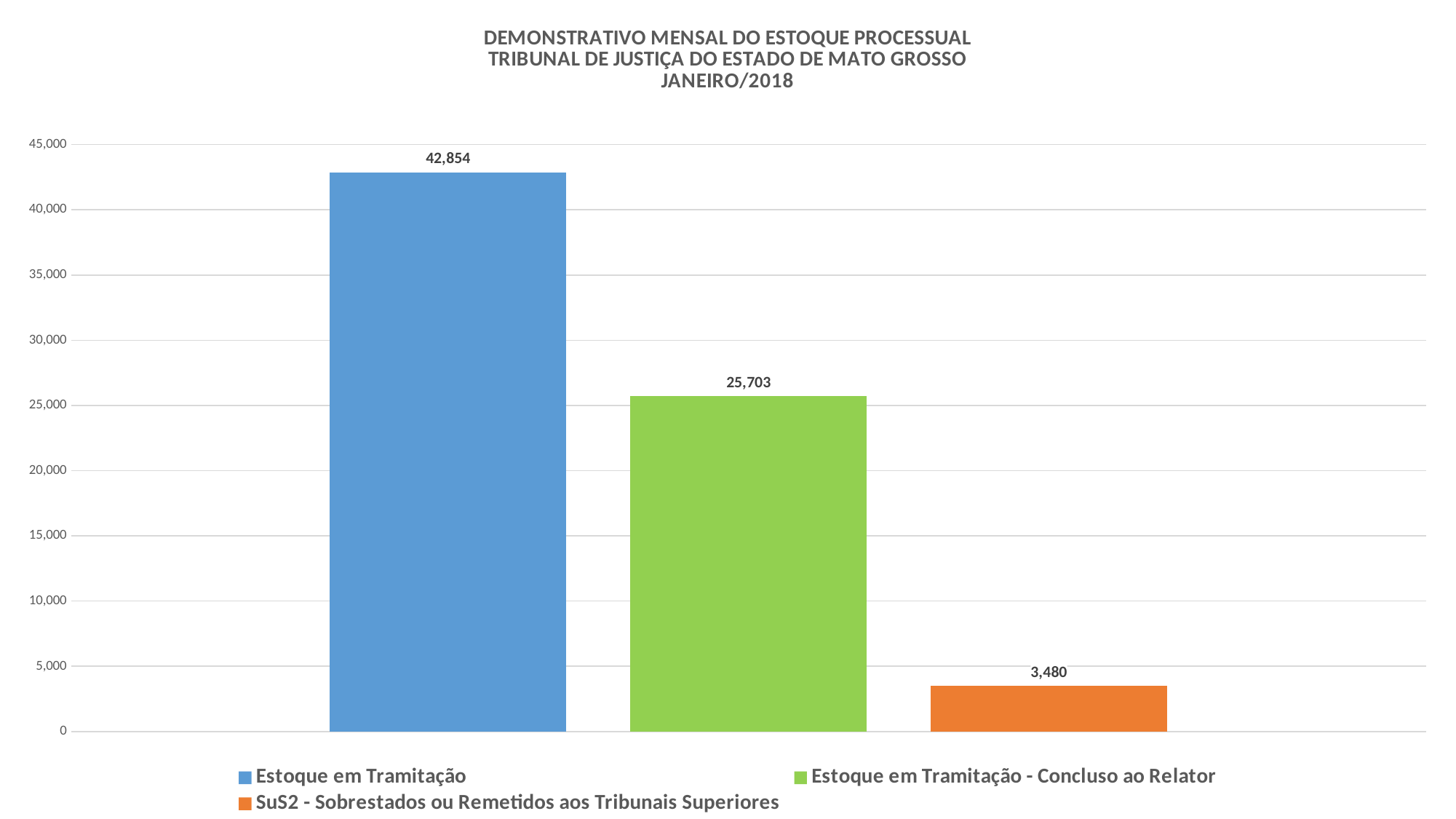
What is the value for Estoque em Tramitação - Concluso ao Relator? 25,703 Is the value for Estoque em Tramitação greater or less than 40,000? greater What is the difference between Estoque em Tramitação - Concluso ao Relator and SuS2 - Sobrestados ou Remetidos aos Tribunais Superiores? 22,223 Which series has the highest value? Estoque em Tramitação Which is larger, Estoque em Tramitação - Concluso ao Relator or SuS2 - Sobrestados ou Remetidos aos Tribunais Superiores? Estoque em Tramitação - Concluso ao Relator What colour is the bar for SuS2 - Sobrestados ou Remetidos aos Tribunais Superiores? orange What kind of chart is shown on the slide? bar chart What is the value for SuS2 - Sobrestados ou Remetidos aos Tribunais Superiores? 3,480 What is the difference between Estoque em Tramitação and Estoque em Tramitação - Concluso ao Relator? 17,151 Which series has the lowest value? SuS2 - Sobrestados ou Remetidos aos Tribunais Superiores What is the value for Estoque em Tramitação? 42,854 How many series does the legend list? 3